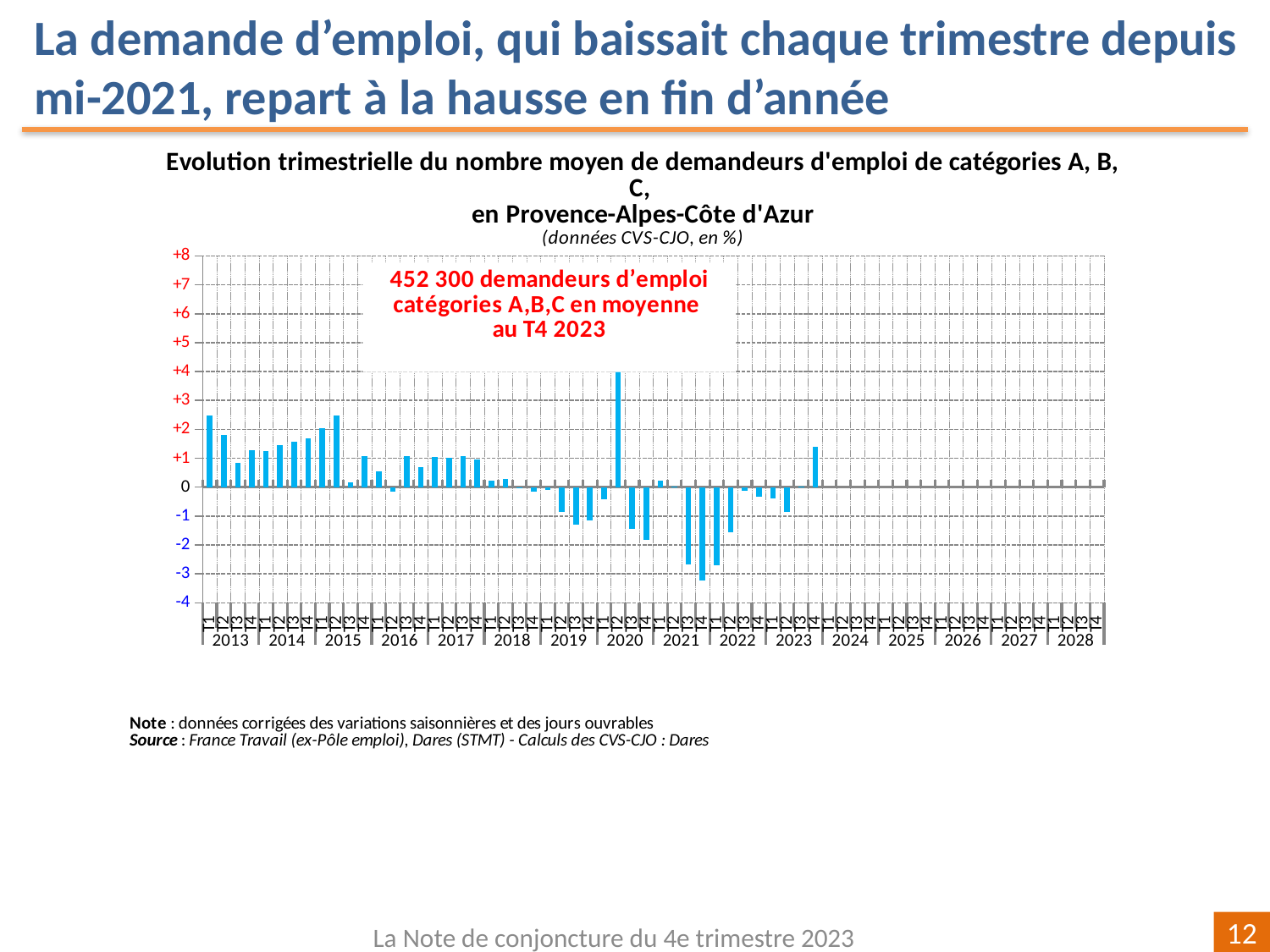
According to the text box on the chart, how many job seekers in categories A, B, C were there on average in T4 2023? 452 300 Is the value for T4 2023 greater or less than +1? greater Is the value for T2 2020 greater or less than +3? greater In which quarter does the chart show the highest quarterly evolution? T2 2020 In which quarter does the chart show the lowest (most negative) quarterly evolution? T4 2021 What kind of chart is shown on the slide? bar chart Is the value for T1 2013 greater or less than +2? greater How many years are labelled on the x axis of the chart? 16 Which is larger, the value for T1 2013 or the value for T2 2013? T1 2013 In what unit are the chart's data expressed, according to the subtitle? % Is the value for T4 2023 positive or negative? positive